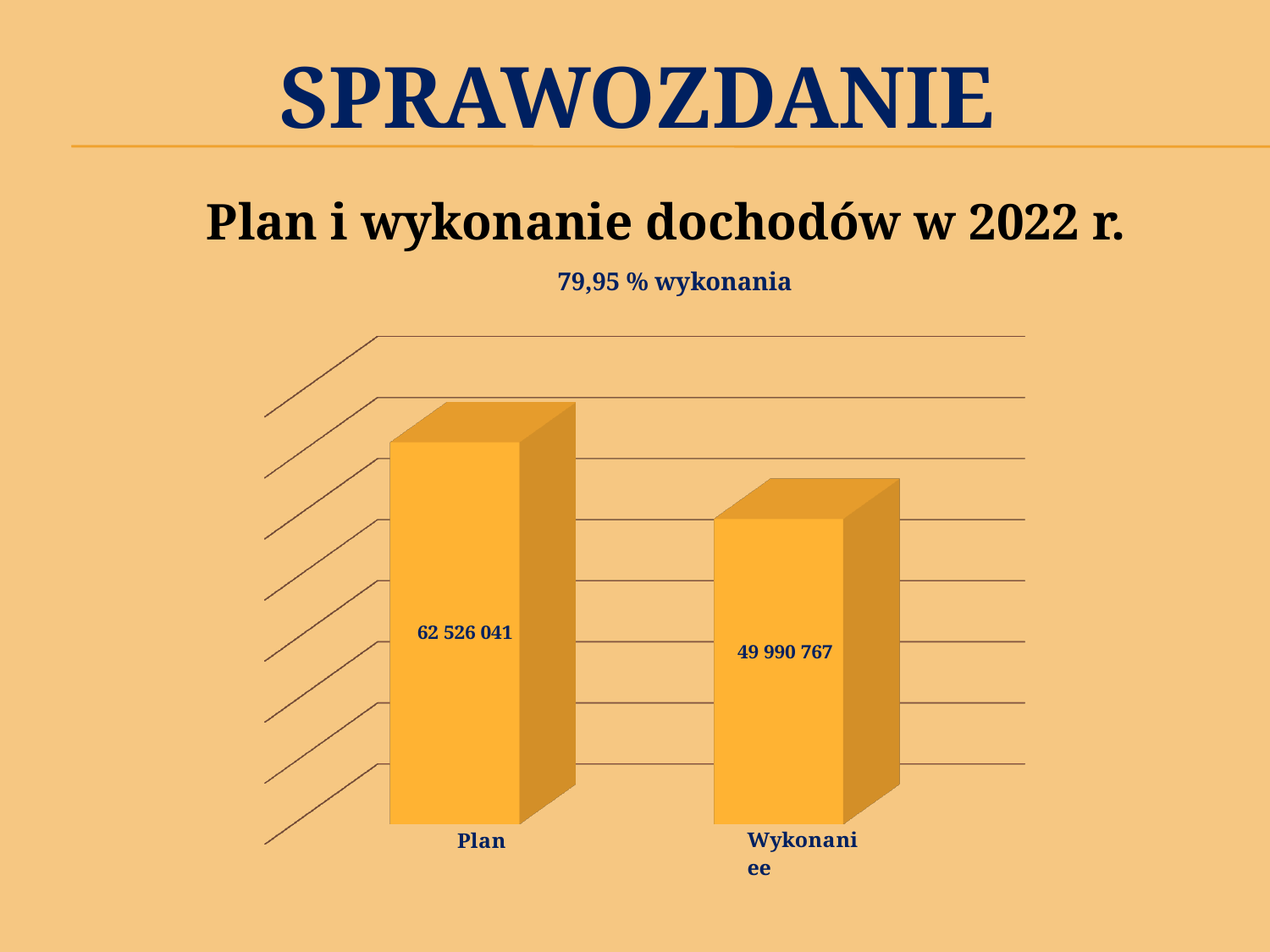
What kind of chart is shown on the slide? Bar chart What is the value of the Wykonanie bar? 49 990 767 Which category has the lowest value? Wykonanie Do the values rise or fall from Plan to Wykonanie? Fall What is the value of the Plan bar? 62 526 041 What percentage of execution (wykonania) is stated above the chart? 79,95 % What is the difference between the Plan value and the Wykonanie value? 12 535 274 What is the title of the chart? Plan i wykonanie dochodów w 2022 r. How many bars are shown in the chart? 2 Which category has the highest value? Plan Which is larger, the Plan value or the Wykonanie value? Plan